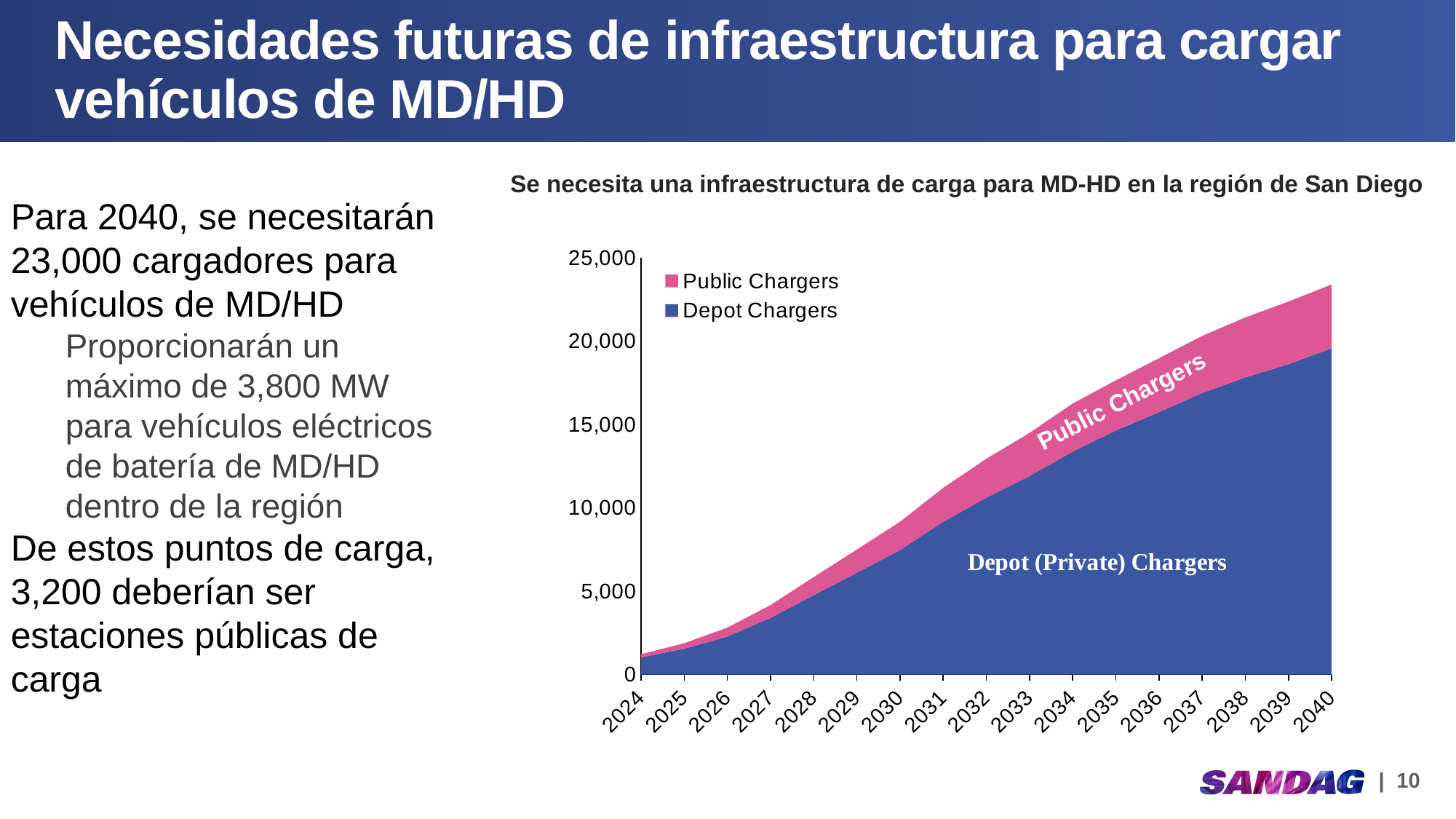
Is the total number of chargers in 2024 greater or less than 5,000? less Does the total number of chargers rise or fall from 2024 to 2040? Rise What is the last year shown on the x axis of the chart? 2040 What kind of chart is shown on the slide? Stacked area chart What are the two series named in the chart legend? Public Chargers and Depot Chargers What is the first year shown on the x axis of the chart? 2024 Which series is shown in pink in the chart? Public Chargers Is the total number of chargers in 2030 greater or less than 10,000? less How many series does the chart legend list? 2 Is the total number of chargers in 2040 greater or less than 20,000? greater How many years are shown along the x axis of the chart? 17